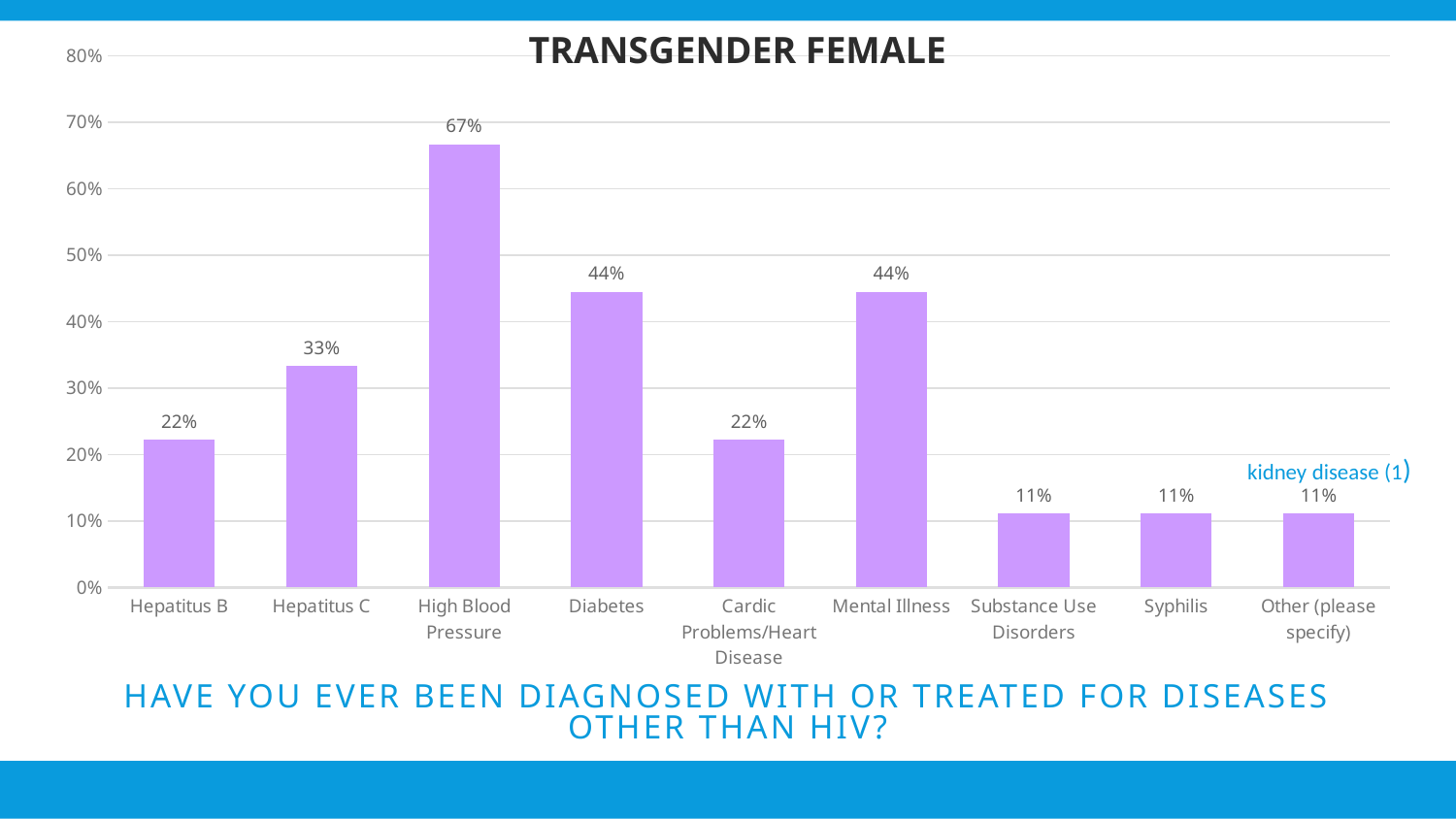
What kind of chart is this? bar chart What is the difference between the values for High Blood Pressure and Diabetes? 23% Which category has the highest value? High Blood Pressure Which is larger, the value for Mental Illness or the value for Cardic Problems/Heart Disease? Mental Illness What is the value for Syphilis? 11% What annotation is written above the Other (please specify) bar? kidney disease (1) How many categories are shown on the x axis? 9 What is the value for Hepatitus C? 33% Is the value for Diabetes greater or less than 40%? greater What is the value for High Blood Pressure? 67% What is the difference between the values for Hepatitus C and Hepatitus B? 11% What is the title of the chart? TRANSGENDER FEMALE